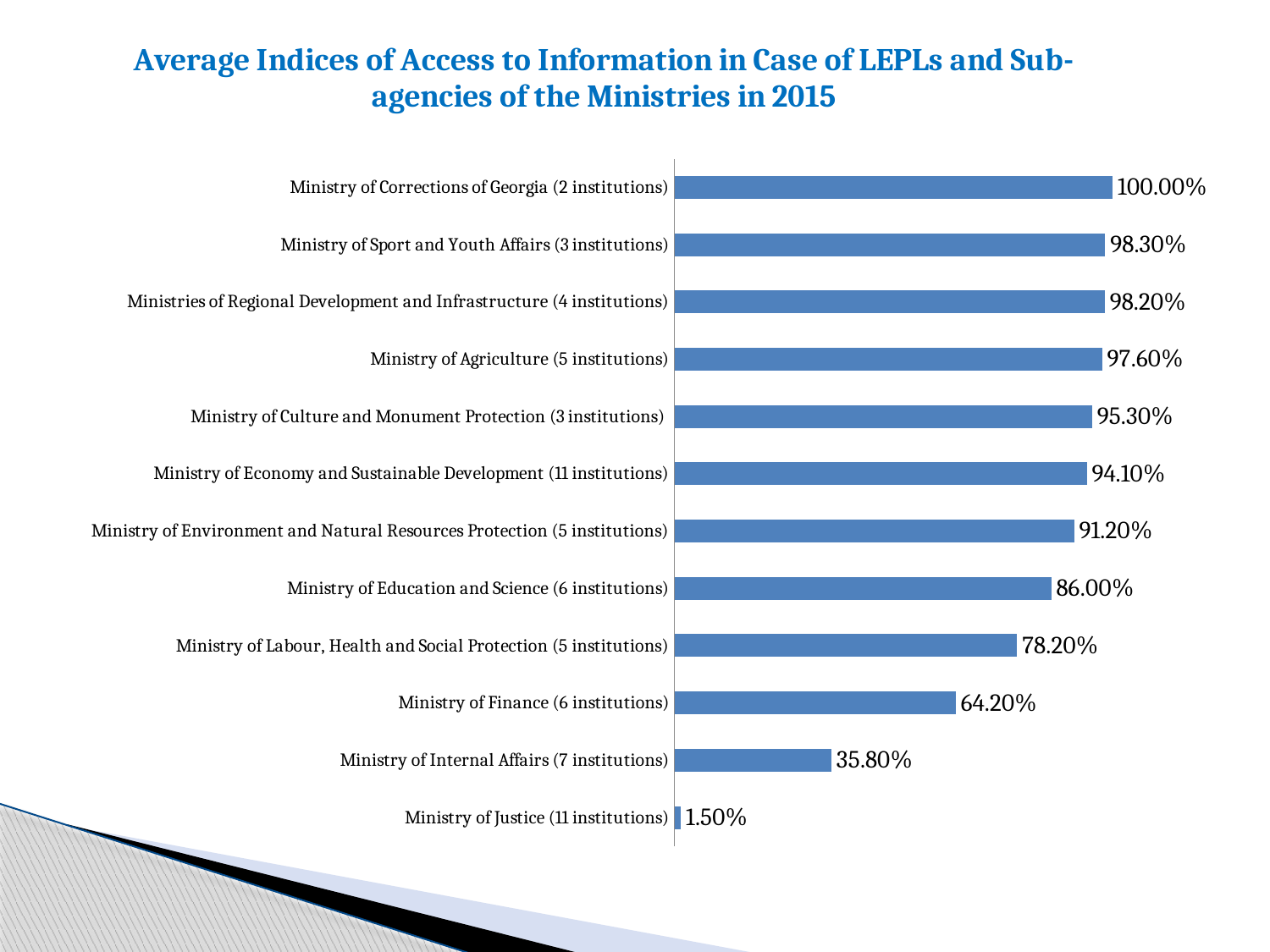
What is the value shown for the Ministry of Education and Science (6 institutions)? 86.00% What is the value shown for the Ministry of Internal Affairs (7 institutions)? 35.80% Which has a higher value: the Ministry of Labour, Health and Social Protection or the Ministry of Finance? Ministry of Labour, Health and Social Protection What is the title of the chart? Average Indices of Access to Information in Case of LEPLs and Sub-agencies of the Ministries in 2015 What is the difference between the values for the Ministry of Finance and the Ministry of Internal Affairs? 28.40% Which ministry has the lowest average index of access to information? Ministry of Justice (11 institutions) Which ministry has the highest average index of access to information? Ministry of Corrections of Georgia (2 institutions) What is the difference between the values for the Ministry of Corrections of Georgia and the Ministry of Justice? 98.50% How many ministries are shown in the chart? 12 What is the value shown for the Ministry of Environment and Natural Resources Protection (5 institutions)? 91.20% What kind of chart is shown on the slide? Bar chart What is the average index of access to information for the Ministry of Finance (6 institutions)? 64.20%